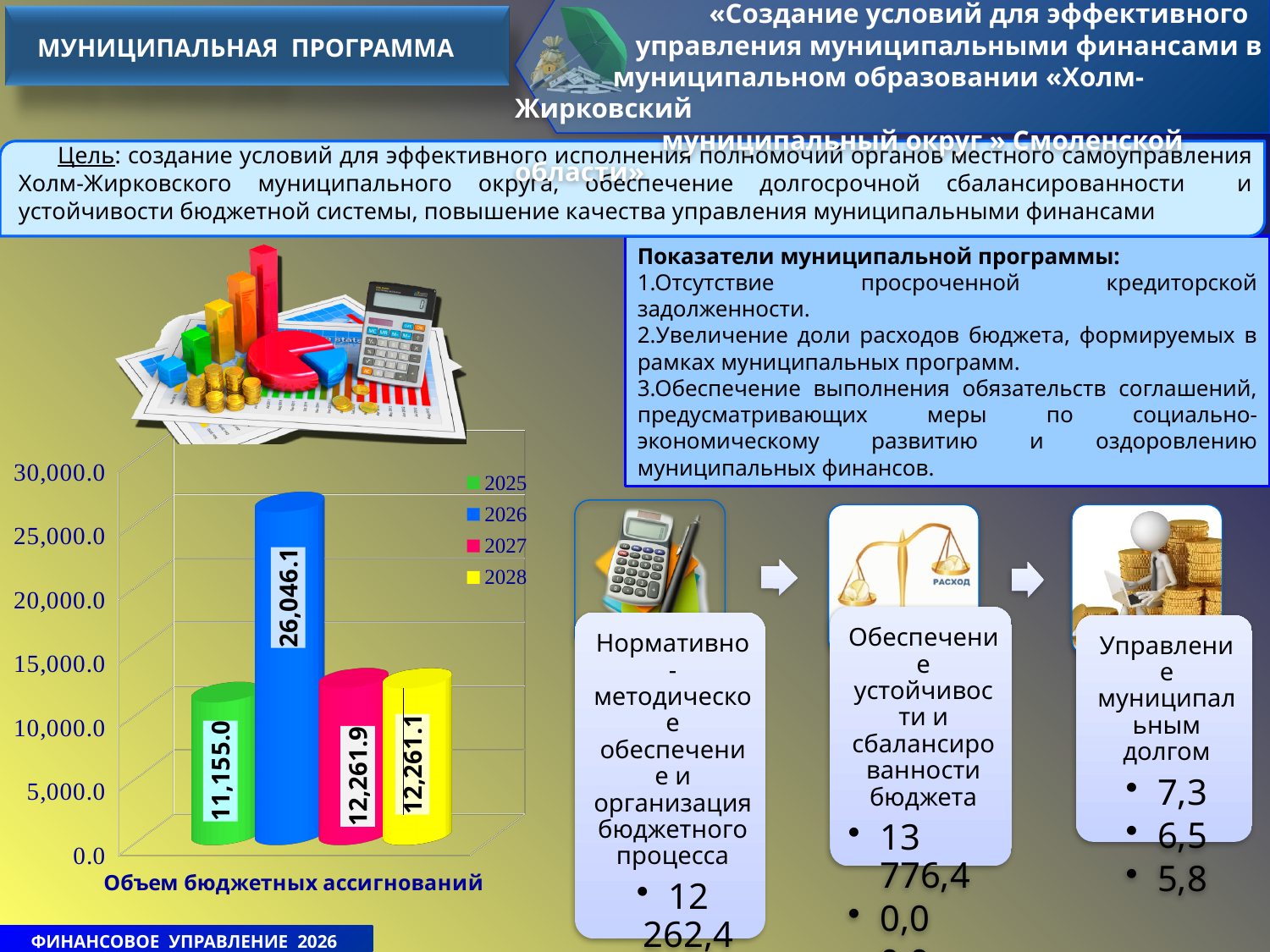
What is the value for 2026 in the chart? 26,046.1 How many series does the chart legend list? 4 Is the value for 2026 greater or less than 25,000.0? greater Which is larger, the value for 2026 or the value for 2027? 2026 What kind of chart is shown on the slide? bar chart What is the title shown under the chart? Объем бюджетных ассигнований What is the value for 2028 in the chart? 12,261.1 What is the difference between the values for 2026 and 2025? 14,891.1 Which year has the lowest value in the chart? 2025 Which year has the highest value in the chart? 2026 What is the value for 2027 in the chart? 12,261.9 What is the value for 2025 in the chart? 11,155.0